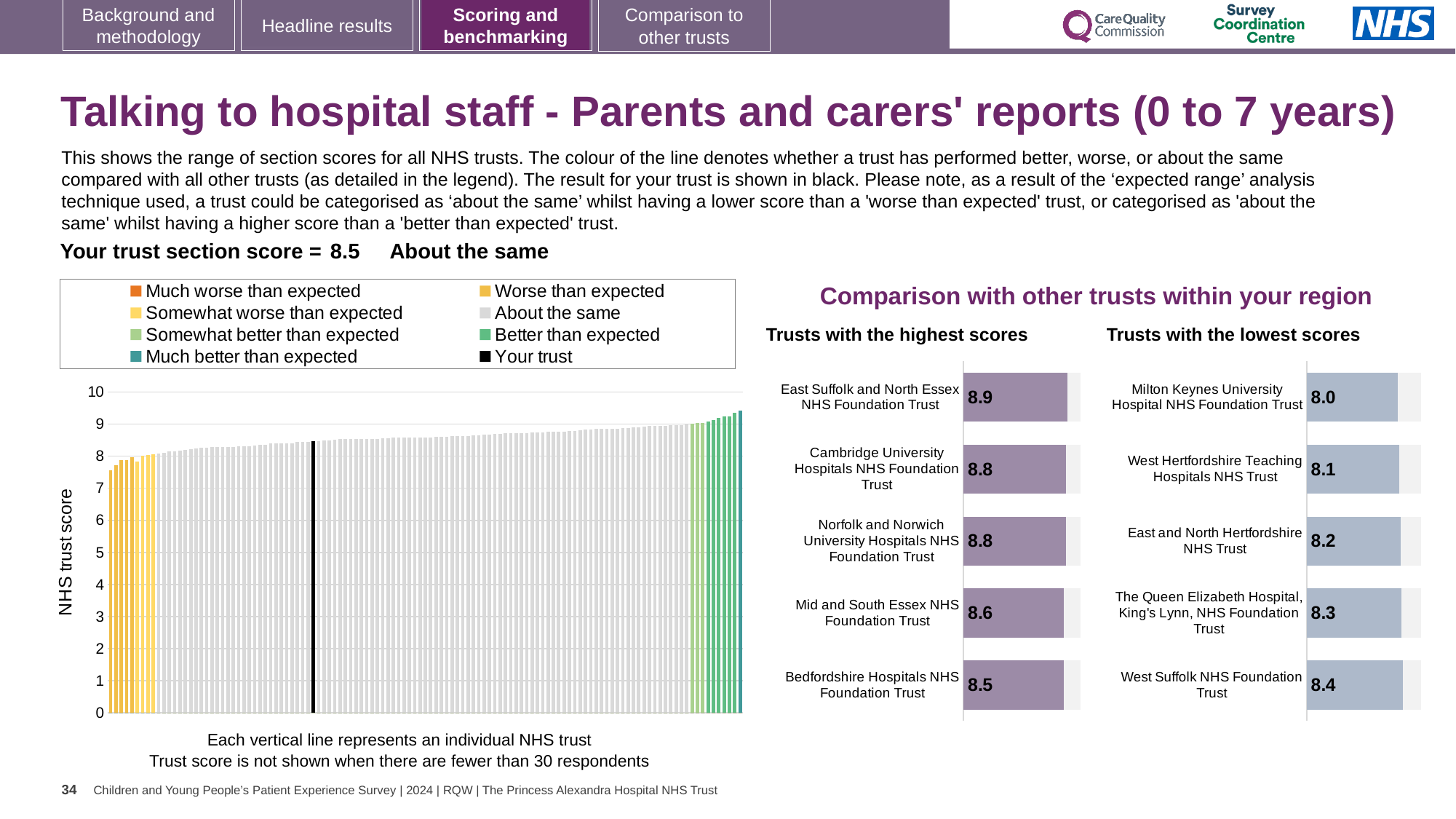
In the large chart on the left, do the trust scores rise or fall from left to right? Rise How many entries does the legend of the large chart on the left list? 8 What is the y-axis label of the large chart on the left? NHS trust score In the 'Trusts with the lowest scores' chart, which has the larger score: West Hertfordshire Teaching Hospitals NHS Trust or The Queen Elizabeth Hospital, King's Lynn, NHS Foundation Trust? The Queen Elizabeth Hospital, King's Lynn, NHS Foundation Trust In the 'Trusts with the lowest scores' chart, what is the difference between the scores of West Suffolk NHS Foundation Trust and Milton Keynes University Hospital NHS Foundation Trust? 0.4 In the 'Trusts with the lowest scores' chart, which trust has the lowest score? Milton Keynes University Hospital NHS Foundation Trust In the 'Trusts with the highest scores' chart, which trust has the highest score? East Suffolk and North Essex NHS Foundation Trust In the 'Trusts with the highest scores' chart, what is the score for East Suffolk and North Essex NHS Foundation Trust? 8.9 In the 'Trusts with the highest scores' chart, what is the difference between the scores of East Suffolk and North Essex NHS Foundation Trust and Bedfordshire Hospitals NHS Foundation Trust? 0.4 How many trusts are shown in the 'Trusts with the highest scores' chart? 5 In the 'Trusts with the lowest scores' chart, what is the score for Milton Keynes University Hospital NHS Foundation Trust? 8.0 What kind of chart is the large chart on the left showing NHS trust scores? Bar chart